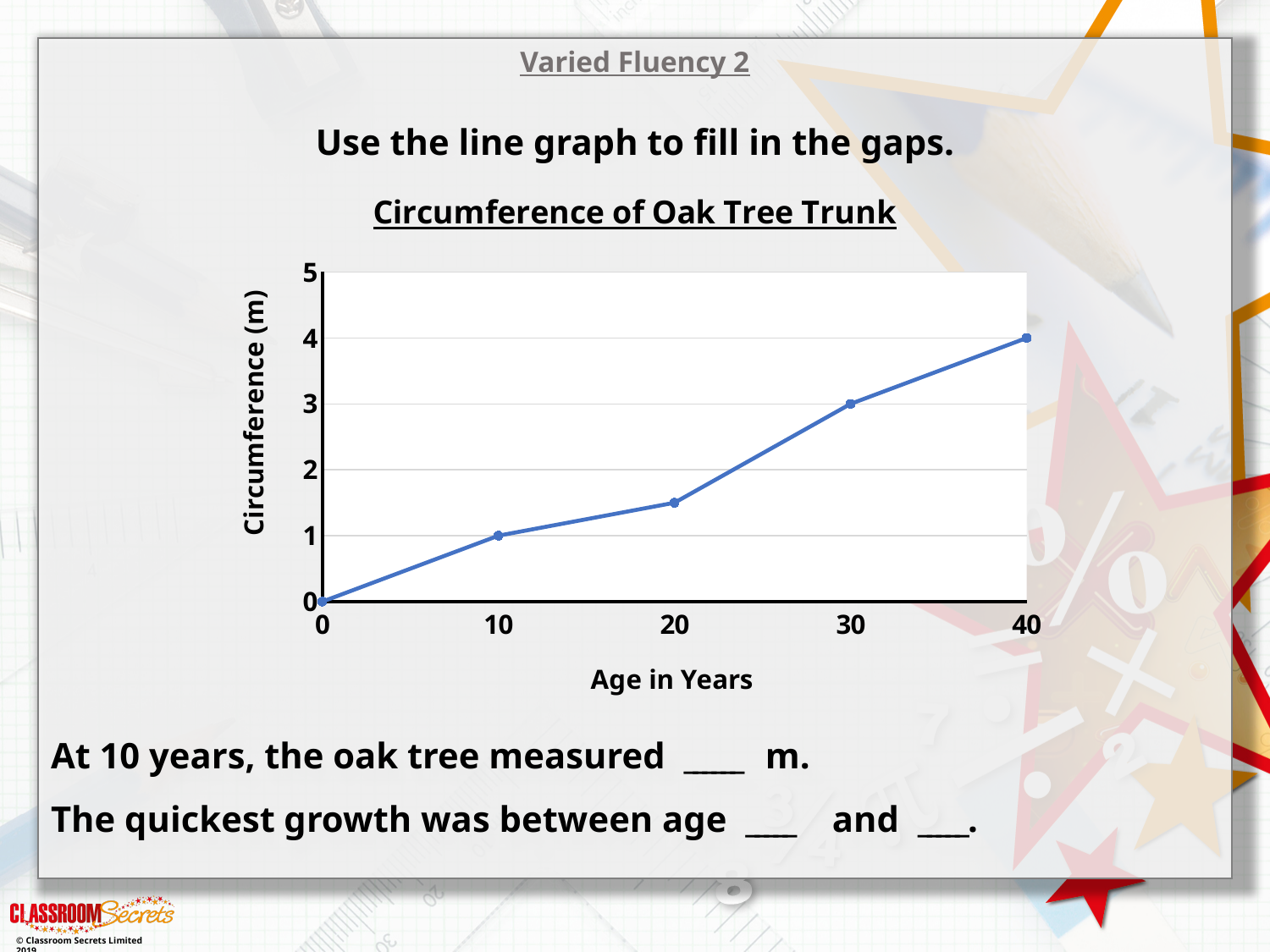
Is the circumference at 20 years greater or less than 2? less Is the circumference at 20 years greater or less than 1? greater What kind of chart is shown on the slide? line chart How many data points are plotted on the line? 5 What is the difference in circumference between 40 years and 30 years? 1 What is the circumference of the oak tree trunk at 10 years? 1 What is the circumference of the oak tree trunk at 30 years? 3 Does the circumference rise or fall as age increases? rise What is the label on the vertical axis? Circumference (m) At which age is the circumference highest? 40 What is the circumference of the oak tree trunk at 0 years? 0 What is the circumference of the oak tree trunk at 40 years? 4